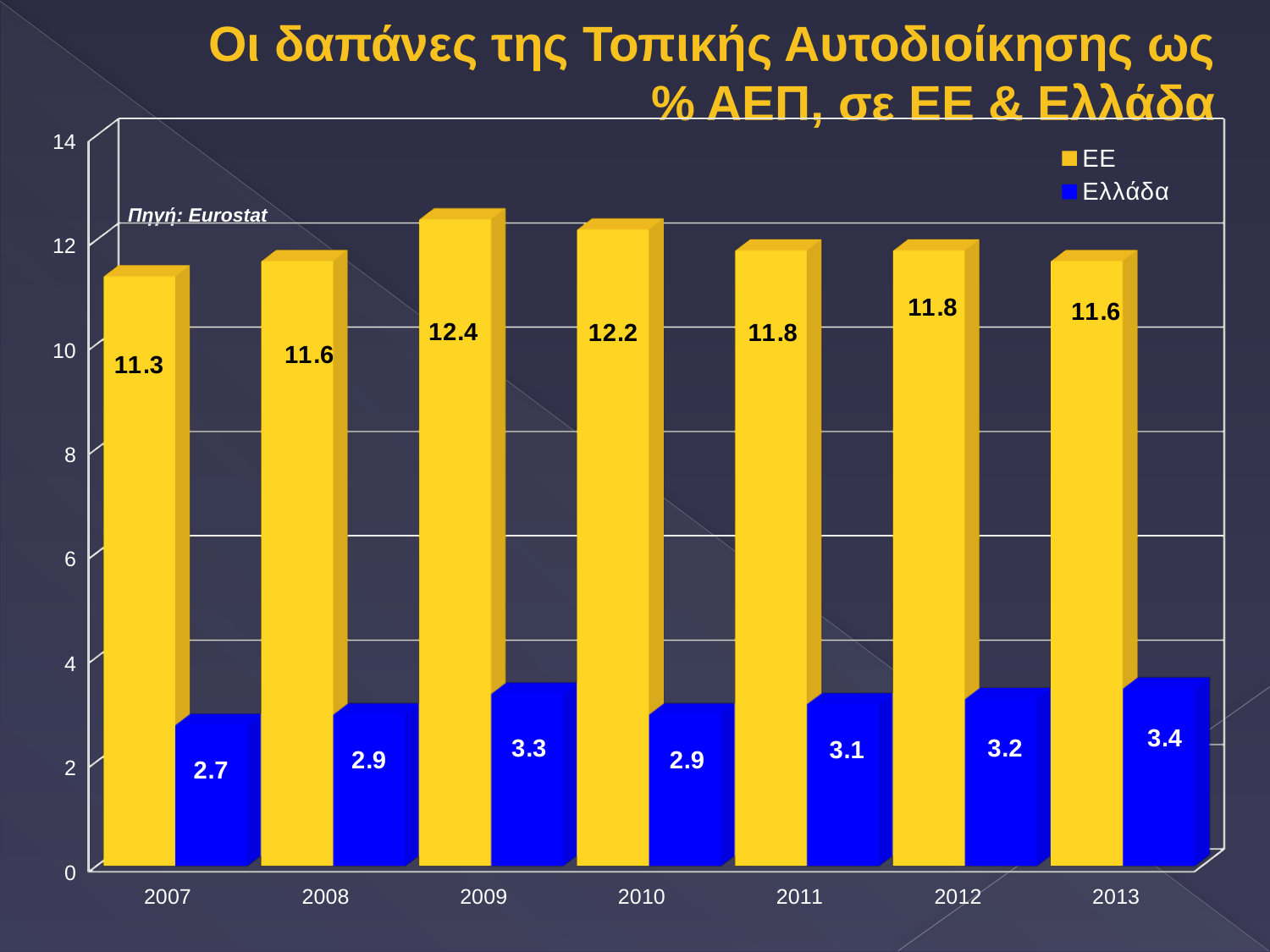
What is the value for Ελλάδα in 2013? 3.4 What is the value for Ελλάδα in 2007? 2.7 What is the difference between the ΕΕ and Ελλάδα values in 2010? 9.3 What source is cited on the chart? Eurostat How many years are shown on the x axis? 7 Which is larger, the Ελλάδα value in 2009 or in 2012? 2009 In which year is the ΕΕ value highest? 2009 How many series does the legend list? 2 What kind of chart is shown on the slide? bar chart What is the value for ΕΕ in 2009? 12.4 Is the ΕΕ value for 2007 greater or less than 12? less In which year is the Ελλάδα value lowest? 2007